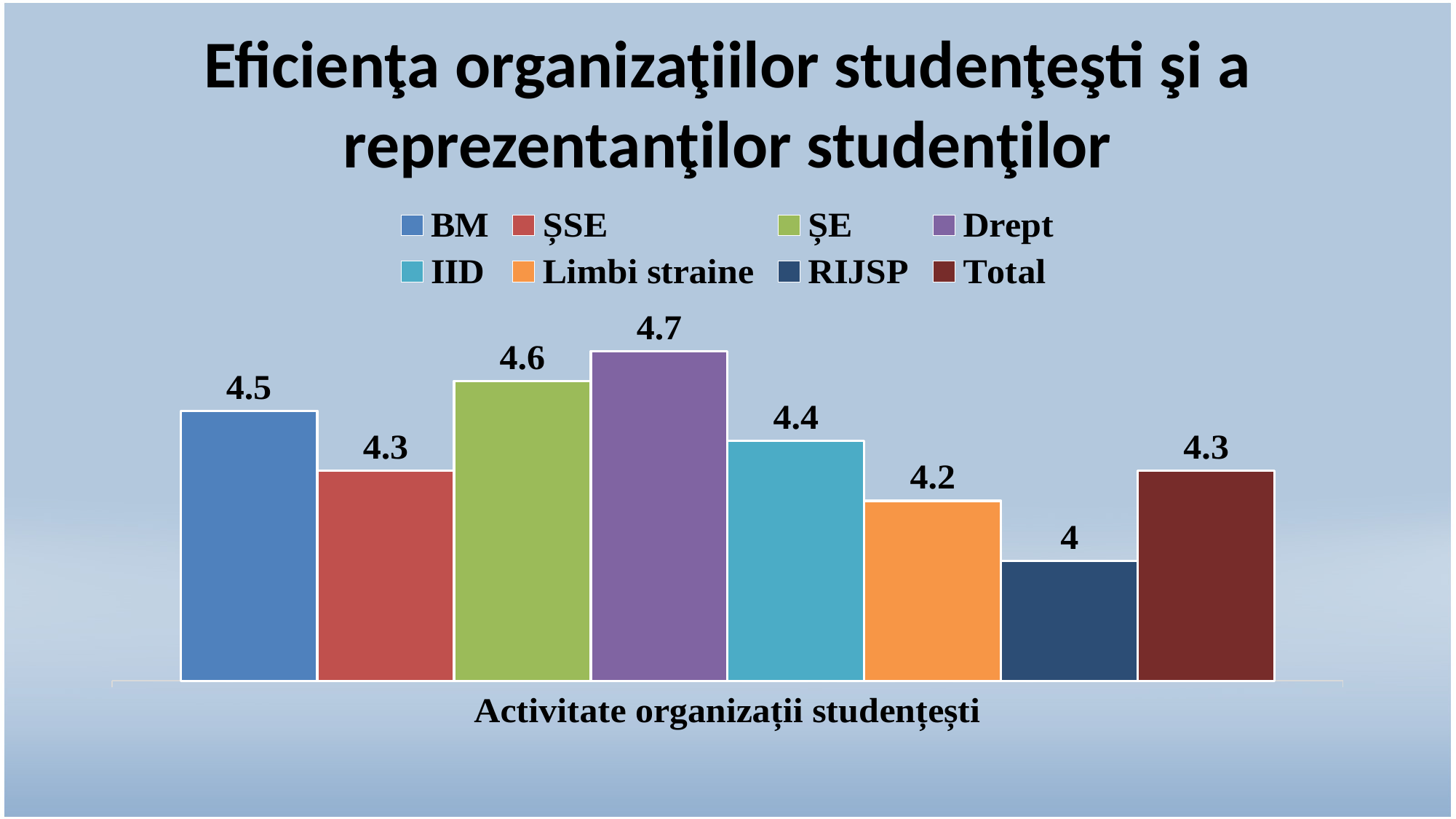
What is the value for Limbi straine? 4.2 What is the difference between the values for Drept and RIJSP? 0.7 What is the label shown on the x axis of the chart? Activitate organizații studențești Which is larger, the value for ȘE or the value for IID? ȘE Which series has the lowest value? RIJSP What kind of chart is shown on the slide? Bar chart Which series has the highest value? Drept What is the value for Drept? 4.7 What is the value for Total? 4.3 How many series does the legend list? 8 What is the difference between the values for BM and ȘSE? 0.2 What is the value for RIJSP? 4